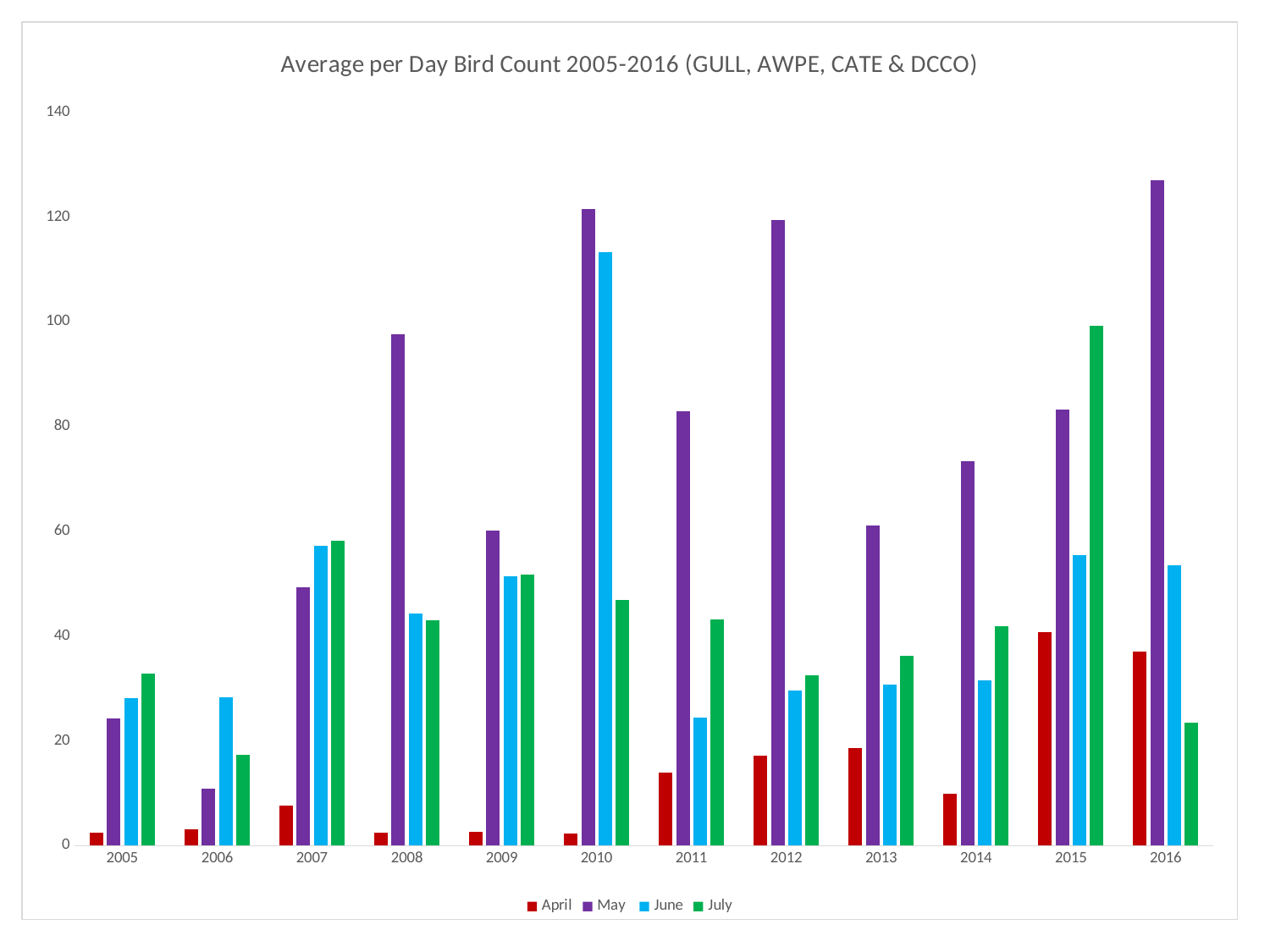
Which year has the highest May value? 2016 What is the title of the chart? Average per Day Bird Count 2005-2016 (GULL, AWPE, CATE & DCCO) Which colour represents April in the legend? red How many series does the legend list? 4 In 2015, which is larger, the July value or the May value? July How many years are shown along the x axis? 12 Is the June value for 2016 greater or less than 60? less In 2008, which is larger, the May value or the June value? May Is the July value for 2015 greater or less than 80? greater What kind of chart is shown on the slide? bar chart Is the May value for 2010 greater or less than 100? greater Which year has the lowest May value? 2006